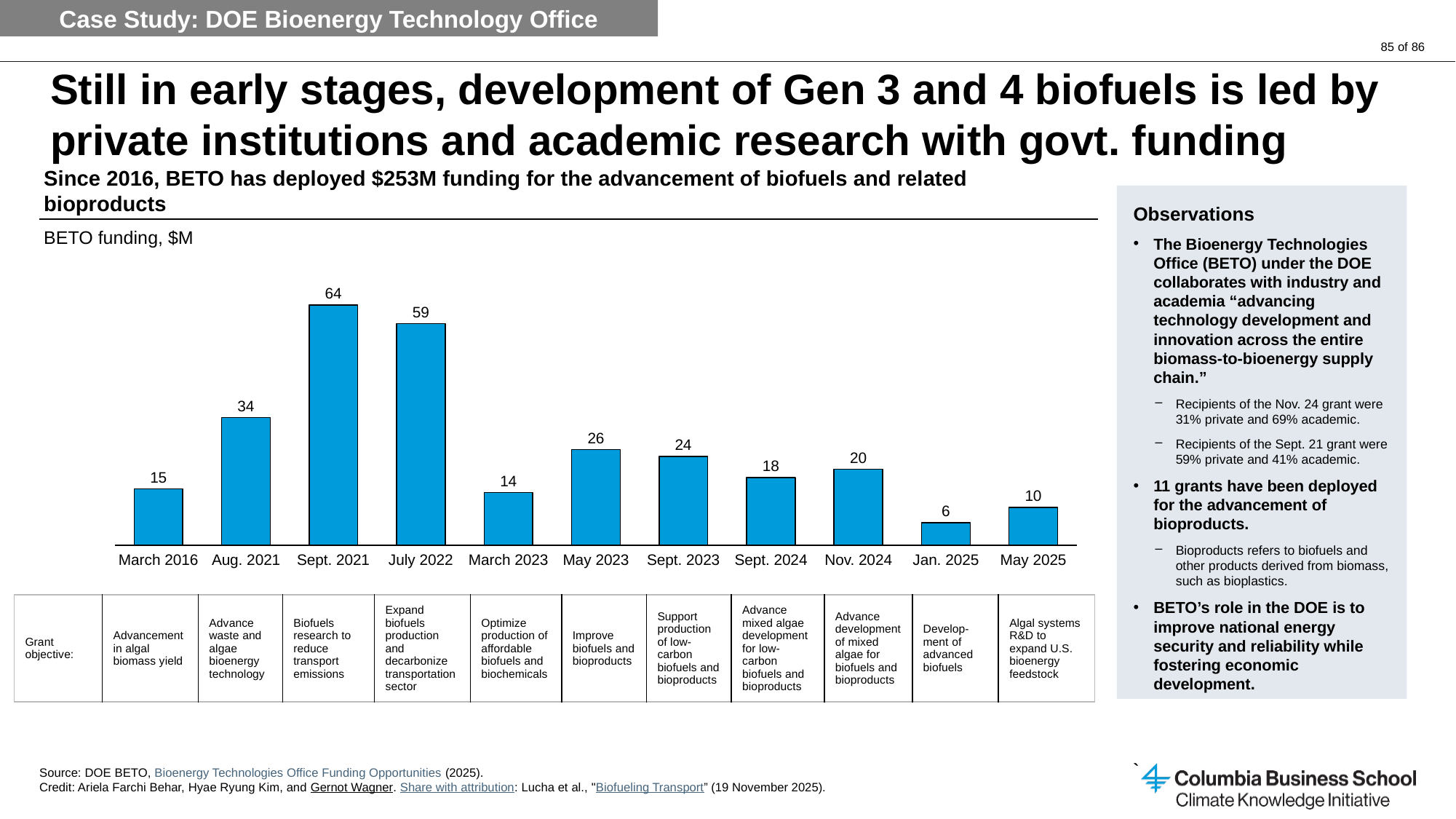
What is the BETO funding value for March 2016? 15 Which grant date has the lowest BETO funding? Jan. 2025 What is the BETO funding value for Sept. 2021? 64 What is the BETO funding value for Nov. 2024? 20 What is the difference in BETO funding between Aug. 2021 and March 2023? 20 What is the difference in BETO funding between Sept. 2021 and July 2022? 5 What kind of chart is used to show BETO funding? Bar chart Which has higher BETO funding, May 2023 or Sept. 2023? May 2023 How many grant dates are shown on the chart? 11 What is the grant objective listed for the Jan. 2025 grant? Development of advanced biofuels Which grant date has the highest BETO funding? Sept. 2021 What unit is BETO funding shown in on the chart? $M